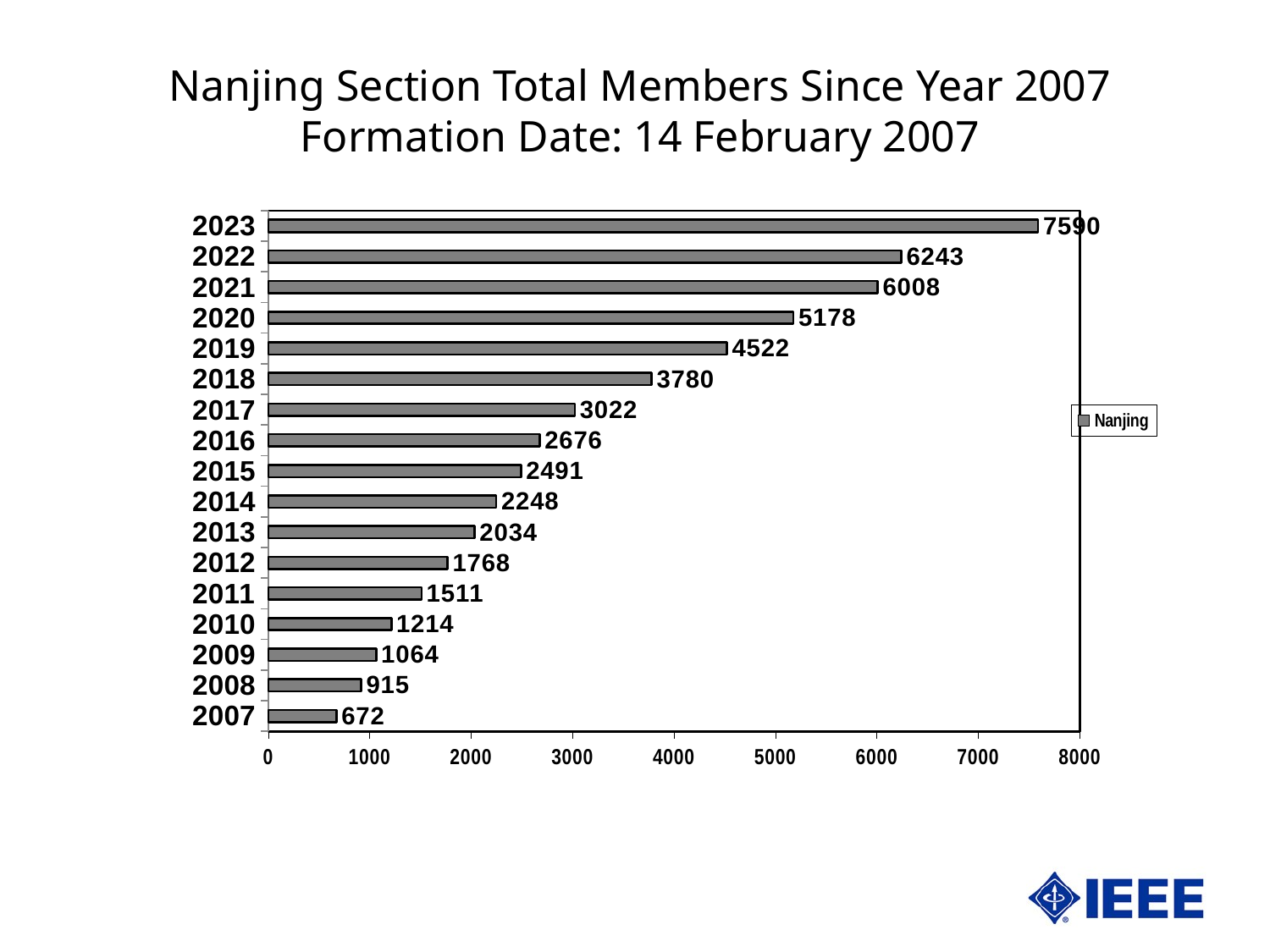
What is the value for 2007? 672 How many years are shown on the chart? 17 Which year has the lowest value? 2007 Is the value for 2021 greater or less than 5000? greater Which is larger, the value for 2020 or the value for 2019? 2020 What series name does the legend show? Nanjing What is the difference between the values for 2018 and 2017? 758 What kind of chart is shown on the slide? bar chart What is the value for 2023? 7590 Which year has the highest value? 2023 What is the value for 2015? 2491 What is the difference between the values for 2023 and 2022? 1347